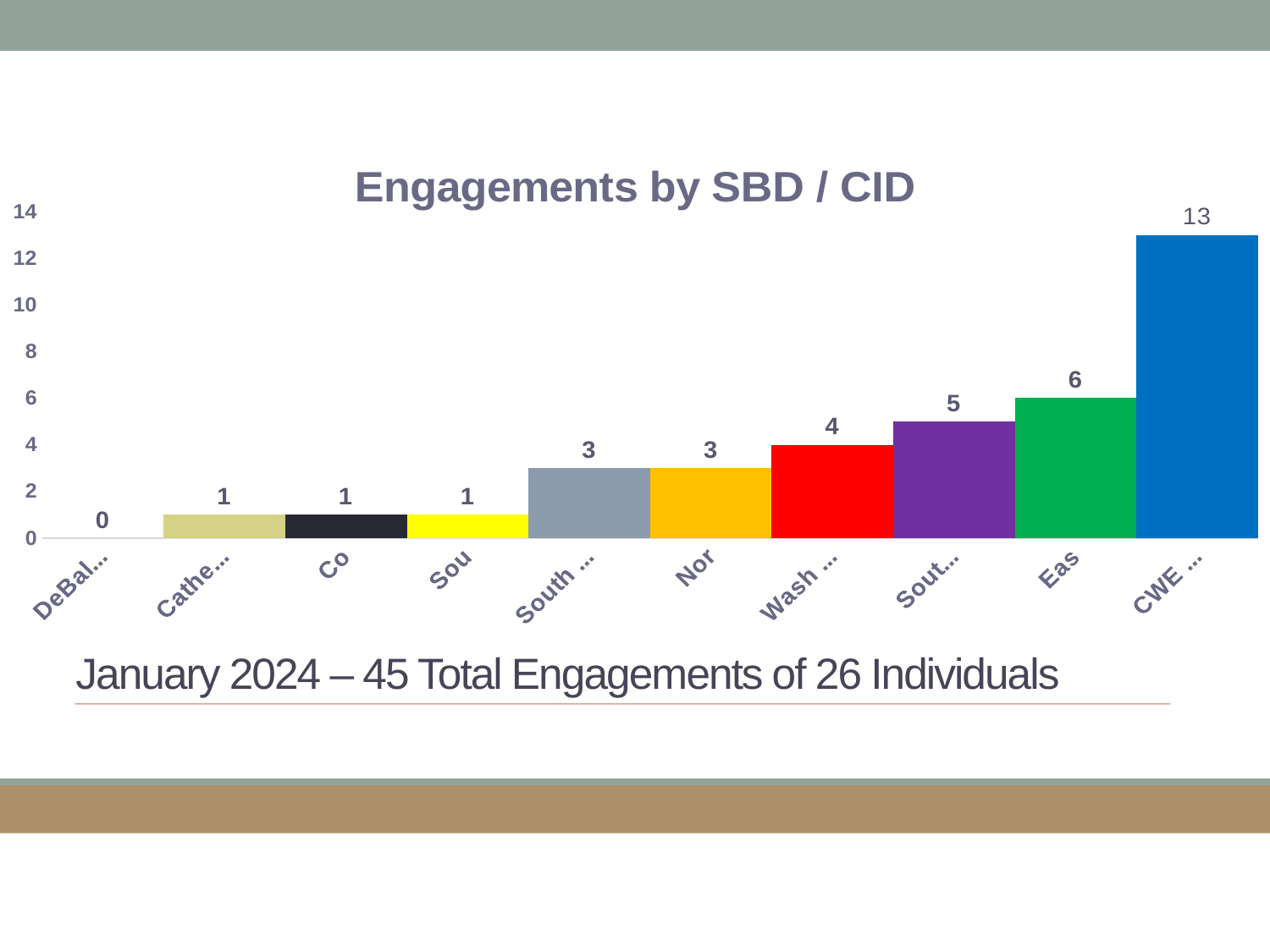
Which bar has the lowest value? DeBal... (the leftmost bar) What is the value of the leftmost bar, labelled "DeBal..."? 0 What is the difference between the value of the "CWE ..." bar and the "Eas" bar? 7 What kind of chart is shown on the slide? bar chart Do the bar values rise or fall from left to right across the chart? rise What is the title of the chart? Engagements by SBD / CID What is the value of the bar labelled "Eas"? 6 Which bar has the highest value? CWE ... (the rightmost bar) What is the value of the bar labelled "Nor"? 3 How many bars (categories) does the chart show? 10 What is the value of the rightmost bar, labelled "CWE ..."? 13 Which is larger, the value for "Wash ..." or the value for "Sout..."? Sout...